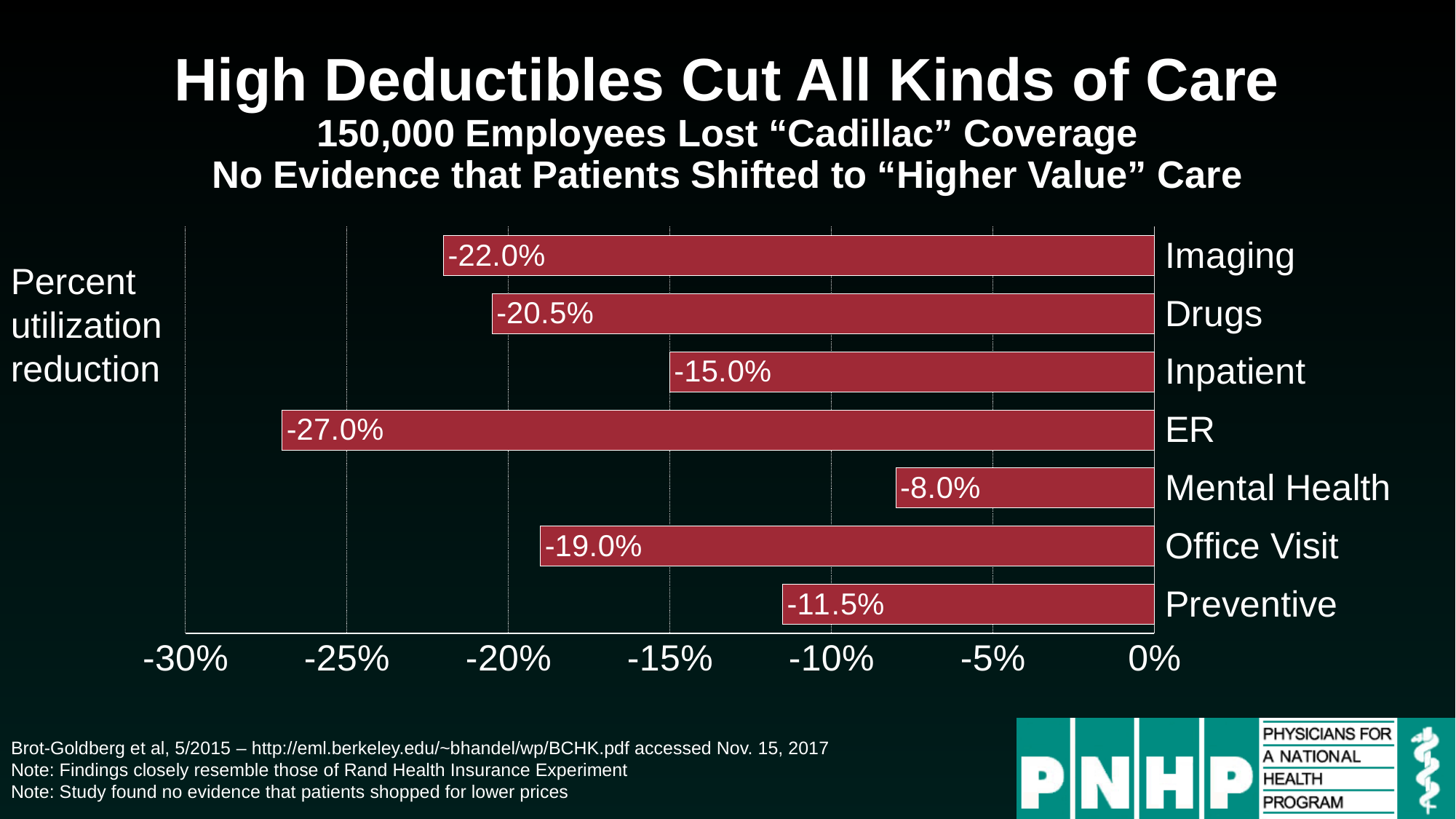
Which category shows the largest utilization reduction? ER What is the percent utilization reduction shown for Imaging? -22.0% Is the value for Preventive greater or less than -10%? less What does the label to the left of the chart say the values represent? Percent utilization reduction What is the value shown for Drugs? -20.5% What kind of chart is shown on the slide? Bar chart Which category shows the smallest utilization reduction? Mental Health Which category has a larger utilization reduction, Office Visit or Inpatient? Office Visit How many categories of care are shown in the chart? 7 By how many percentage points does the ER reduction exceed the Mental Health reduction? 19.0 percentage points What is the value shown for Preventive? -11.5% What value is labeled on the ER bar? -27.0%